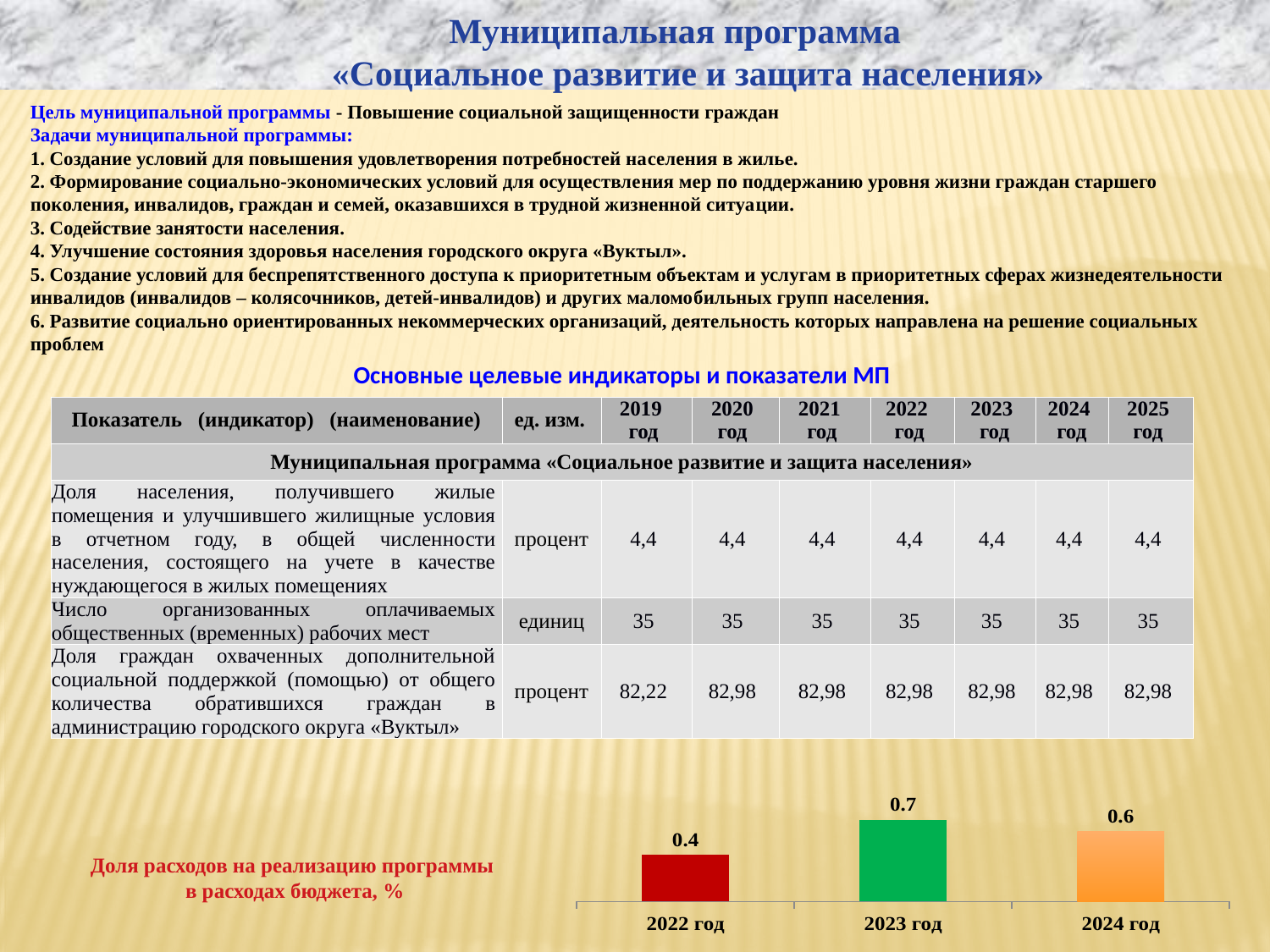
In the chart 'Доля расходов на реализацию программы в расходах бюджета, %', which is larger: the value for 2024 год or the value for 2022 год? 2024 год In the chart 'Доля расходов на реализацию программы в расходах бюджета, %', does the value rise or fall from 2022 год to 2023 год? rise What is the value for 2023 год in the chart 'Доля расходов на реализацию программы в расходах бюджета, %'? 0.7 In the chart 'Доля расходов на реализацию программы в расходах бюджета, %', what is the difference between the values for 2023 год and 2022 год? 0.3 What kind of chart is 'Доля расходов на реализацию программы в расходах бюджета, %'? bar chart What is the value for 2022 год in the chart 'Доля расходов на реализацию программы в расходах бюджета, %'? 0.4 What colour is the bar for 2023 год in the chart 'Доля расходов на реализацию программы в расходах бюджета, %'? green How many years (bars) are shown in the chart 'Доля расходов на реализацию программы в расходах бюджета, %'? 3 Which year has the highest value in the chart 'Доля расходов на реализацию программы в расходах бюджета, %'? 2023 год Which year has the lowest value in the chart 'Доля расходов на реализацию программы в расходах бюджета, %'? 2022 год What is the value for 2024 год in the chart 'Доля расходов на реализацию программы в расходах бюджета, %'? 0.6 In the chart 'Доля расходов на реализацию программы в расходах бюджета, %', what is the difference between the values for 2023 год and 2024 год? 0.1